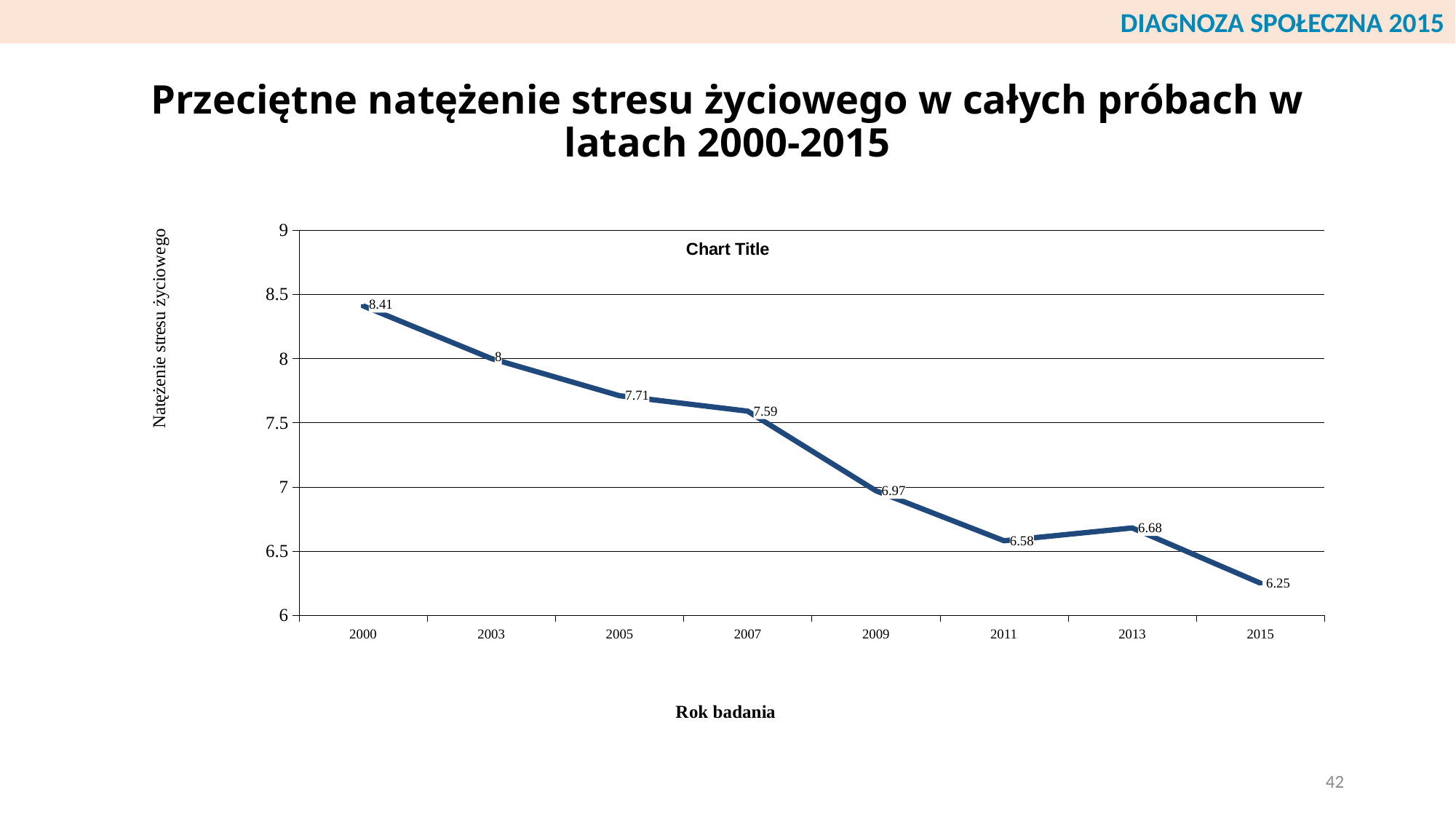
Which year has the lowest value? 2015 Do the values generally rise or fall from 2000 to 2015? fall What is the difference between the values for 2000 and 2015? 2.16 What is the label of the x axis? Rok badania What is the value for 2000? 8.41 Is the value for 2007 greater or less than 7.5? greater Which year has the highest value? 2000 What kind of chart is shown? line chart Which is larger, the value for 2011 or the value for 2013? 2013 What is the value for 2015? 6.25 How many years are plotted on the chart? 8 What is the value for 2009? 6.97